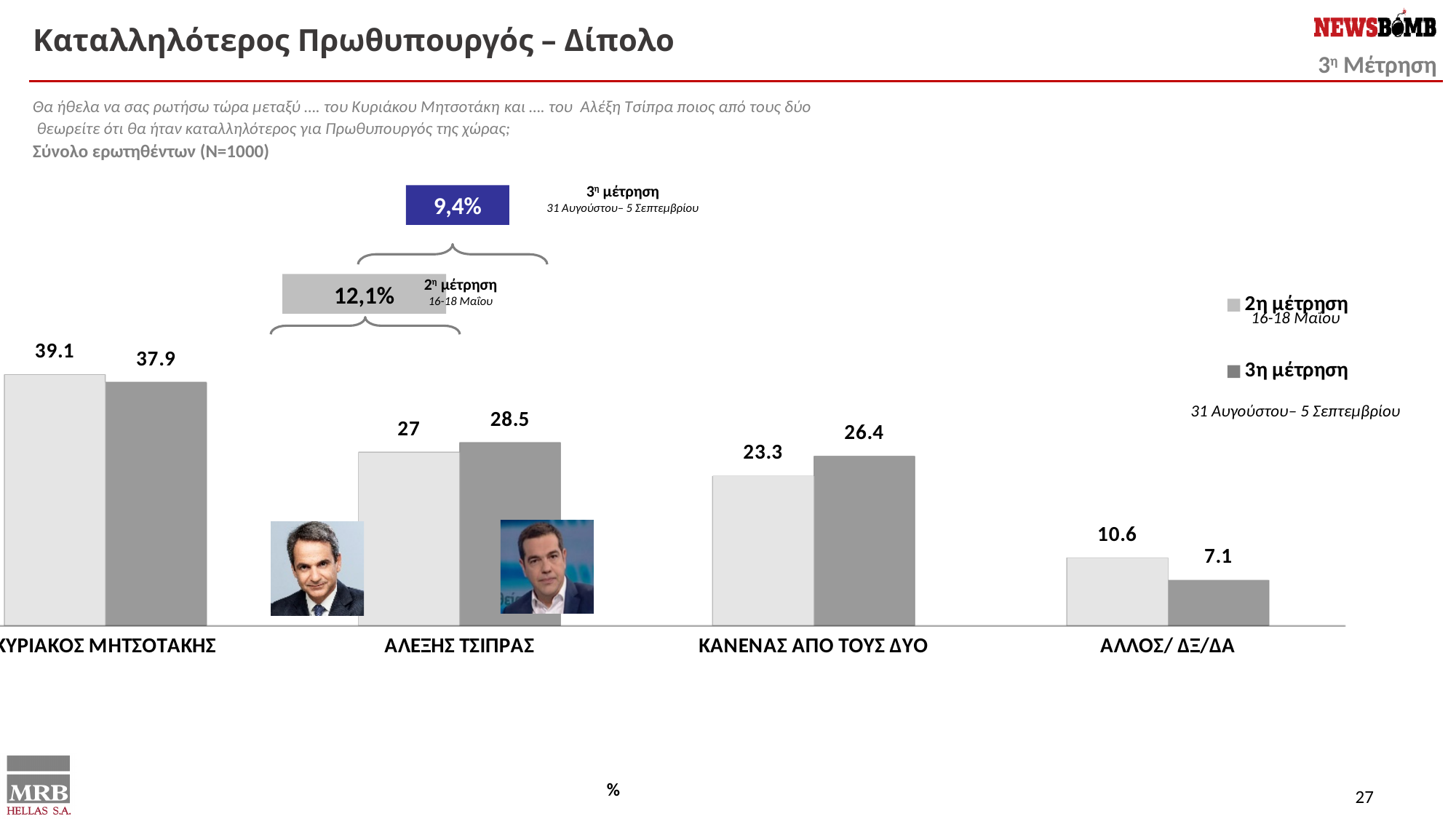
Which is larger for ΑΛΕΞΗΣ ΤΣΙΠΡΑΣ: the 2η μέτρηση value or the 3η μέτρηση value? 3η μέτρηση What is the value for ΚΥΡΙΑΚΟΣ ΜΗΤΣΟΤΑΚΗΣ in the 3η μέτρηση series? 37.9 What is the difference between the 2η μέτρηση and 3η μέτρηση values for ΑΛΛΟΣ/ ΔΞ/ΔΑ? 3.5 What is the value for ΑΛΛΟΣ/ ΔΞ/ΔΑ in the 2η μέτρηση series? 10.6 Which category has the lowest value in the 2η μέτρηση series? ΑΛΛΟΣ/ ΔΞ/ΔΑ Which category has the highest value in the 3η μέτρηση series? ΚΥΡΙΑΚΟΣ ΜΗΤΣΟΤΑΚΗΣ What percentage gap between ΚΥΡΙΑΚΟΣ ΜΗΤΣΟΤΑΚΗΣ and ΑΛΕΞΗΣ ΤΣΙΠΡΑΣ is shown in the callout for the 3η μέτρηση? 9,4% What is the value for ΚΑΝΕΝΑΣ ΑΠΟ ΤΟΥΣ ΔΥΟ in the 3η μέτρηση series? 26.4 How many categories are shown on the x axis of the chart? 4 What is the value for ΑΛΕΞΗΣ ΤΣΙΠΡΑΣ in the 2η μέτρηση series? 27 What kind of chart is shown on the slide? bar chart How many series does the legend list? 2